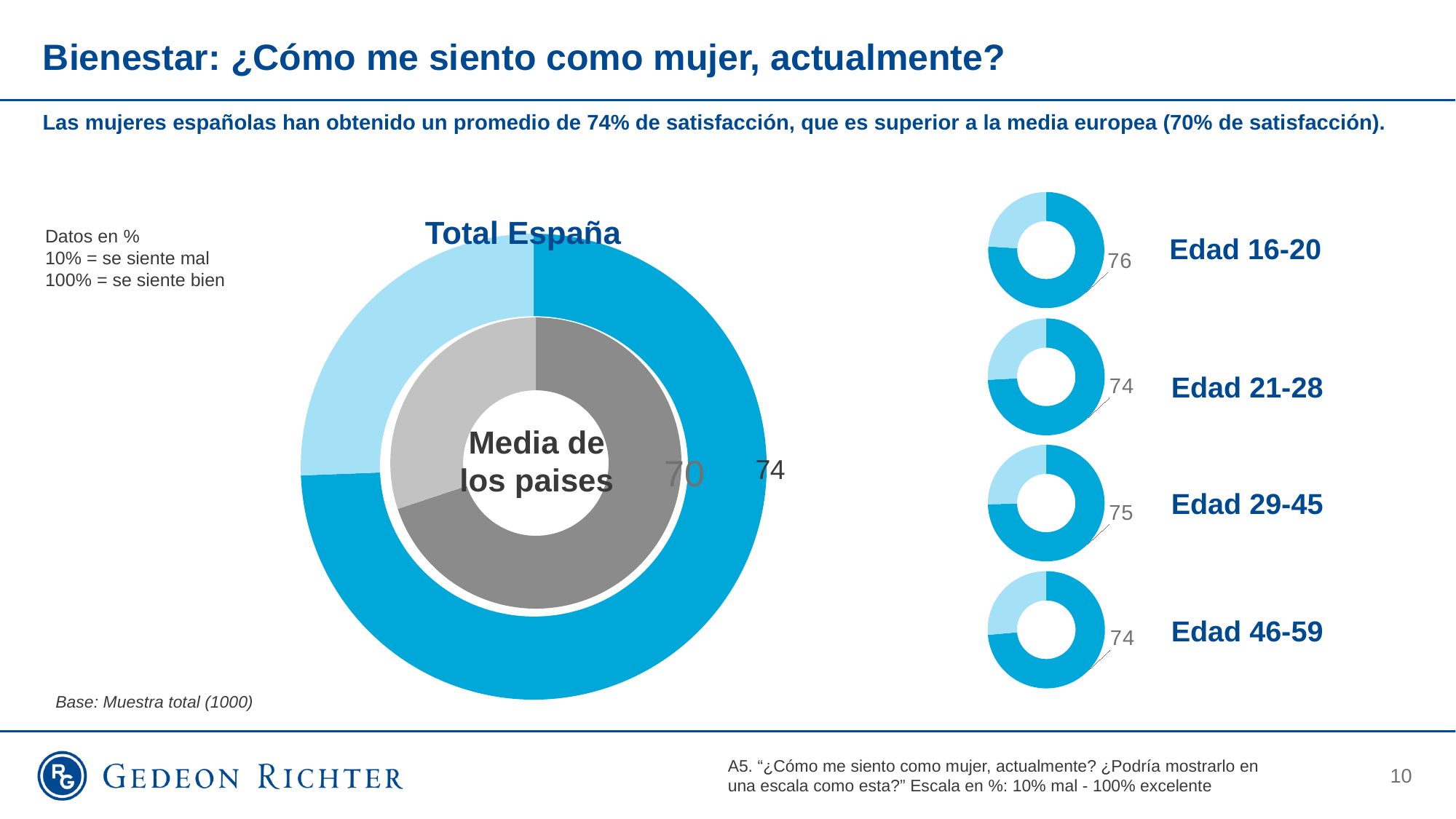
What is the title shown above the large donut chart? Total España In the small donut charts on the right, what is the value for Edad 46-59? 74 Among the small donut charts on the right, which age group has the highest value? Edad 16-20 What type of chart is used to show the Total España value? Donut chart In the large donut chart, what is the difference between the Total España value and the Media de los paises value? 4 In the large donut chart, what is the value shown for Total España? 74 How many small age-group donut charts are shown on the right of the slide? 4 In the small donut charts on the right, what is the difference between the values for Edad 16-20 and Edad 21-28? 2 In the large donut chart, what is the value shown for Media de los paises? 70 In the large donut chart, which is larger: Total España or Media de los paises? Total España In the small donut charts on the right, what is the value for Edad 16-20? 76 In the small donut charts on the right, what is the value for Edad 29-45? 75